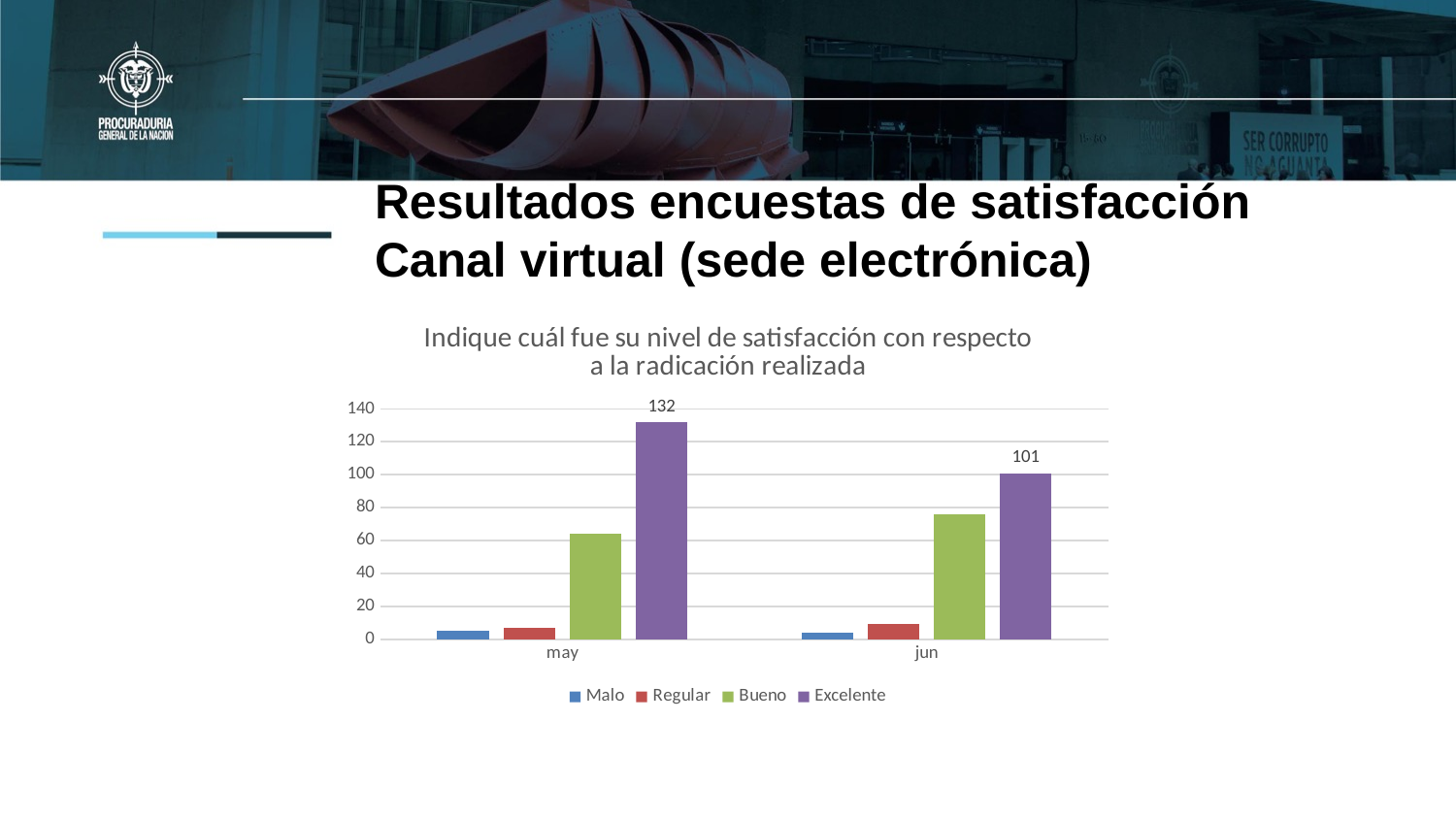
Which series has the lowest value in jun? Malo Which series has the highest value in may? Excelente What is the value for Excelente in jun? 101 Which month has the higher Bueno value, may or jun? jun What is the difference between the Excelente values for may and jun? 31 Which month has the higher Excelente value, may or jun? may Is the value for Bueno in may greater or less than 80? less How many series does the legend list? 4 How many months are shown on the x axis? 2 Is the value for Bueno in jun greater or less than 60? greater What is the value for Excelente in may? 132 What kind of chart is shown on the slide? bar chart